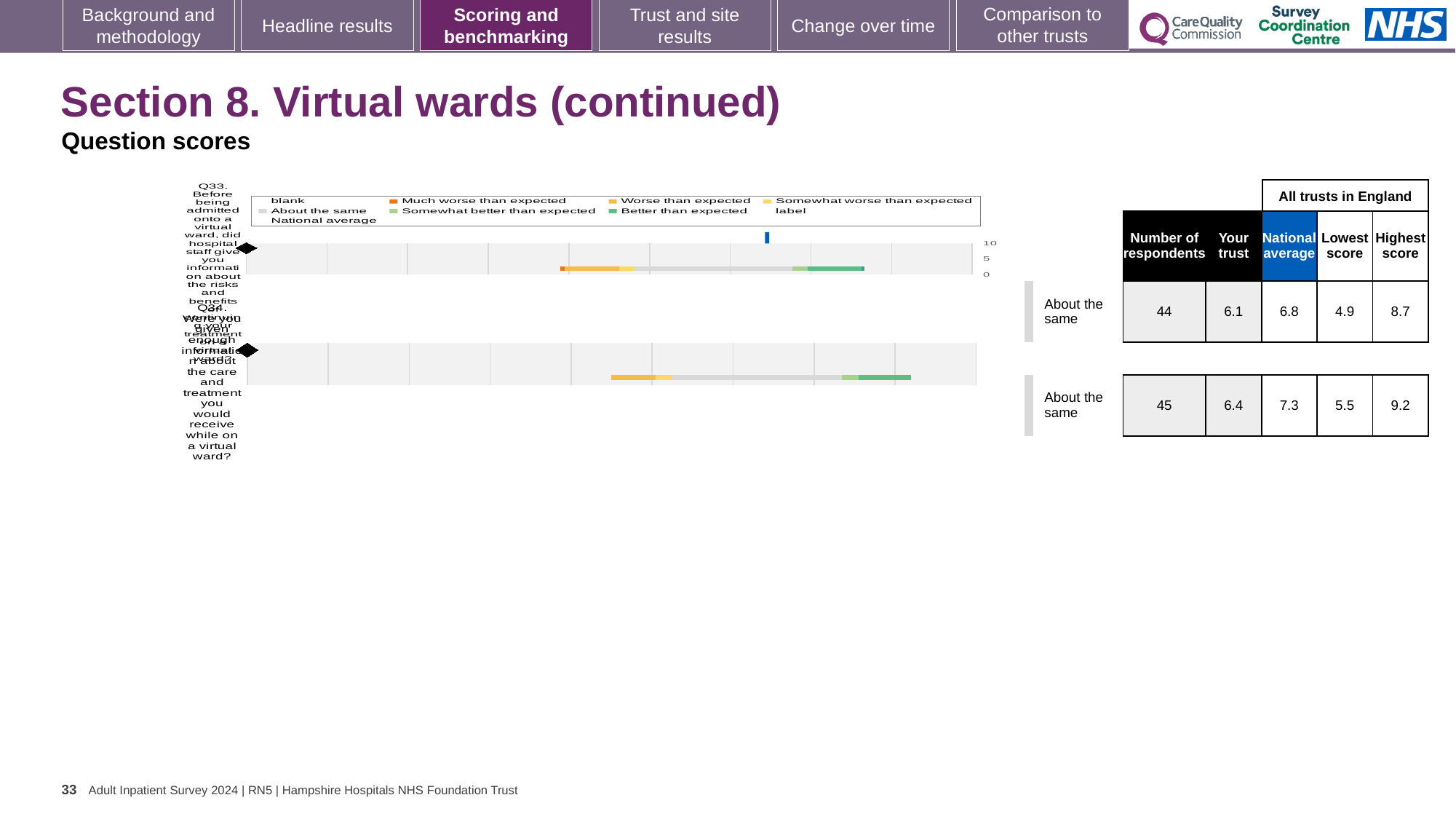
What kind of chart is shown on the slide? bar chart What is the difference between the national average and the 'Your trust' score for Q33? 0.7 What is the highest value shown on the chart's horizontal axis? 10 What is the highest score among all trusts in England for Q34? 9.2 What is the national average score for Q33? 6.8 What is the 'Your trust' score for Q34 (enough information about care and treatment on a virtual ward)? 6.4 How many question bars (categories) does the chart show? 2 How many respondents answered Q34? 45 What is the national average score for Q34? 7.3 Which legend entry is shown in orange in the chart legend? Much worse than expected Which question has the higher 'Your trust' score, Q33 or Q34? Q34 What is the 'Your trust' score for Q33 (information about the risks and benefits of a virtual ward)? 6.1